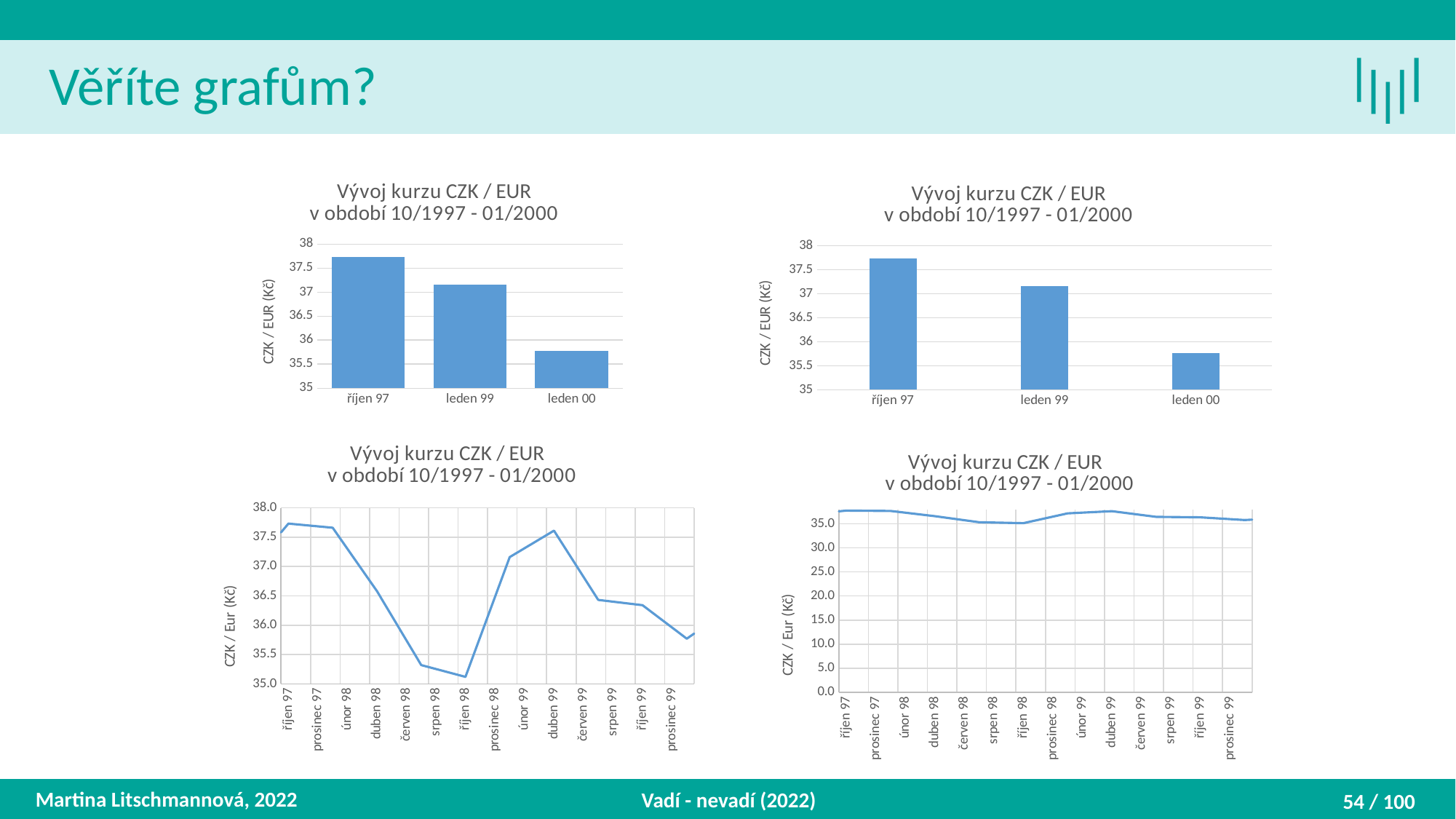
In the bottom-left chart, is the value for duben 99 greater or less than 37.0? greater In the bottom-left chart, which month has the lowest value? říjen 98 In the top-left chart, which category has the highest value? říjen 97 What kind of chart is the top-left chart? bar chart What kind of chart is the bottom-left chart? line chart In the top-left chart, how many categories are shown on the x axis? 3 In the top-right chart, is the value for leden 99 greater or less than 36.5? greater In the top-left chart, is the value for leden 00 greater or less than 36? less In the bottom-left chart, does the line rise or fall between únor 99 and duben 99? rise In the top-right chart, which category has the lowest value? leden 00 What is the y-axis label of the bottom-right chart? CZK / Eur (Kč)